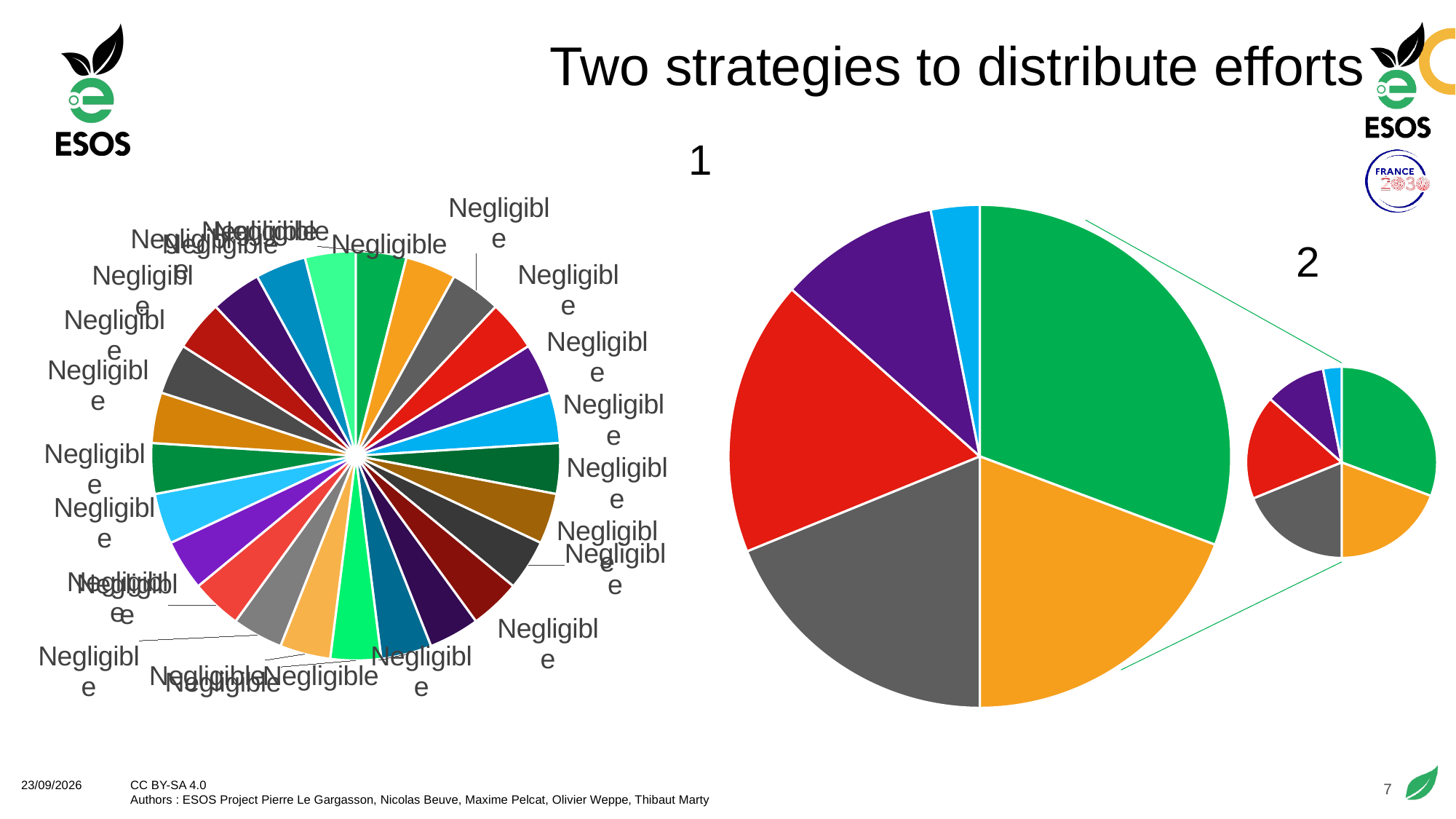
In chart 2 (the large pie on the right), which slice is larger, the grey one or the light blue one? grey In chart 2 (the large pie on the right), which slice is larger, the red one or the purple one? red In chart 2 (the large pie on the right), how many slices does the pie have? 6 What kind of chart is chart 1 on the left of the slide? pie chart In chart 1 (the left pie), what label is shown on the slices? Negligible In chart 2 (the large pie on the right), which colour slice is the smallest? light blue What kind of chart is chart 2 on the right of the slide? pie chart What is the title of the slide containing the two pie charts? Two strategies to distribute efforts In chart 2 (the large pie on the right), which colour slice is the largest? green In chart 2 (the large pie on the right), which slice is larger, the green one or the orange one? green